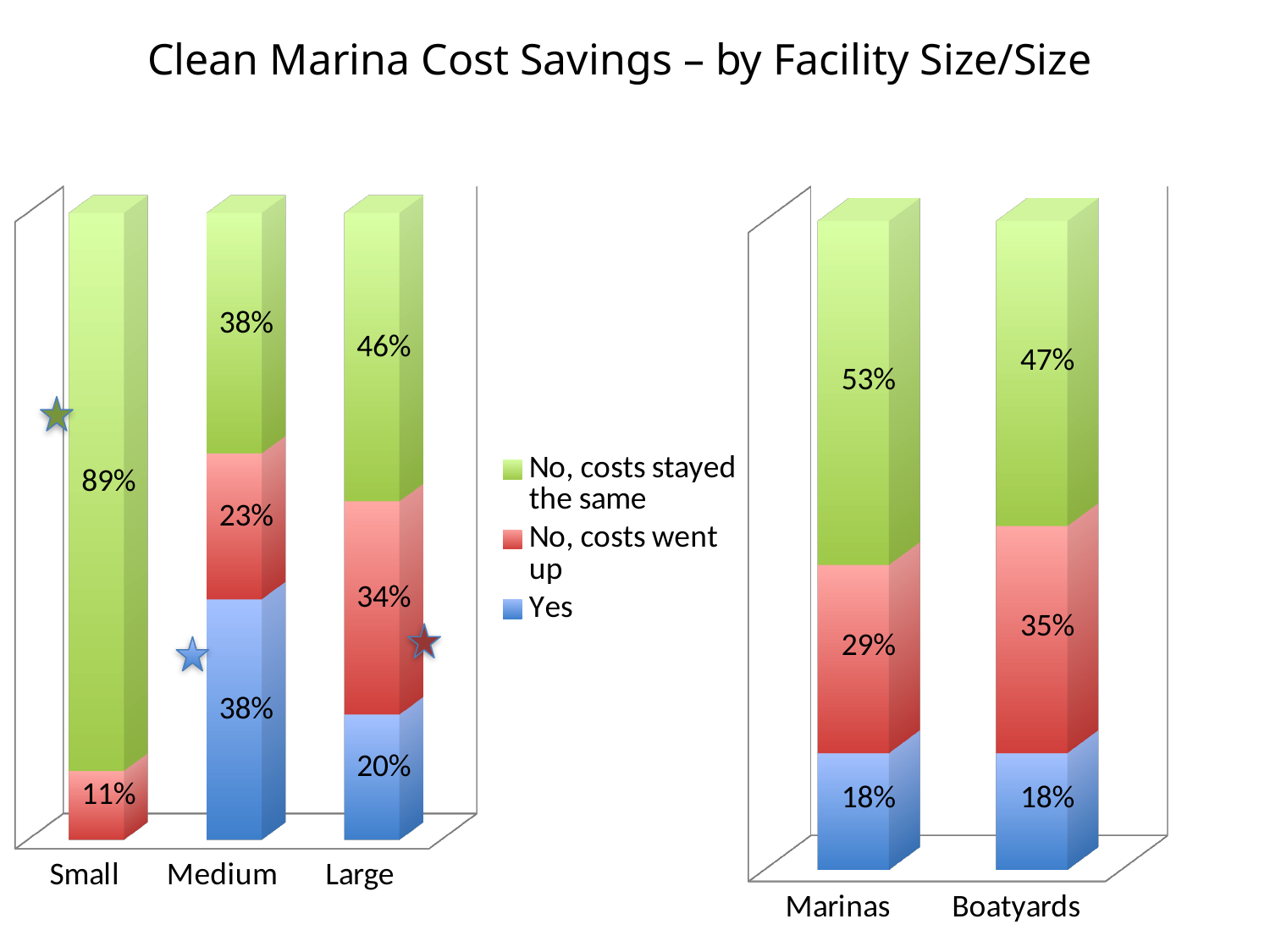
In the left chart (by facility size), which facility size has the lowest 'No, costs went up' percentage? Small What kind of chart is the right chart (Marinas vs Boatyards)? Stacked bar chart In the right chart (Marinas vs Boatyards), what is the 'Yes' value for Marinas? 18% In the left chart (by facility size), what percentage of Large facilities reported that costs went up? 34% How many categories are shown on the x axis of the left chart (by facility size)? 3 How many series does the legend list? 3 In the left chart (by facility size), which is larger: the 'Yes' value for Medium or the 'Yes' value for Large? Medium In the right chart (Marinas vs Boatyards), what is the 'No, costs went up' value for Boatyards? 35% In the left chart (by facility size), which facility size has the highest 'No, costs stayed the same' percentage? Small In the left chart (by facility size), what percentage of Small facilities reported that costs stayed the same? 89% In the left chart (by facility size), what is the 'Yes' value for Medium facilities? 38% In the right chart (Marinas vs Boatyards), what is the difference between the 'No, costs stayed the same' values for Marinas and Boatyards? 6%